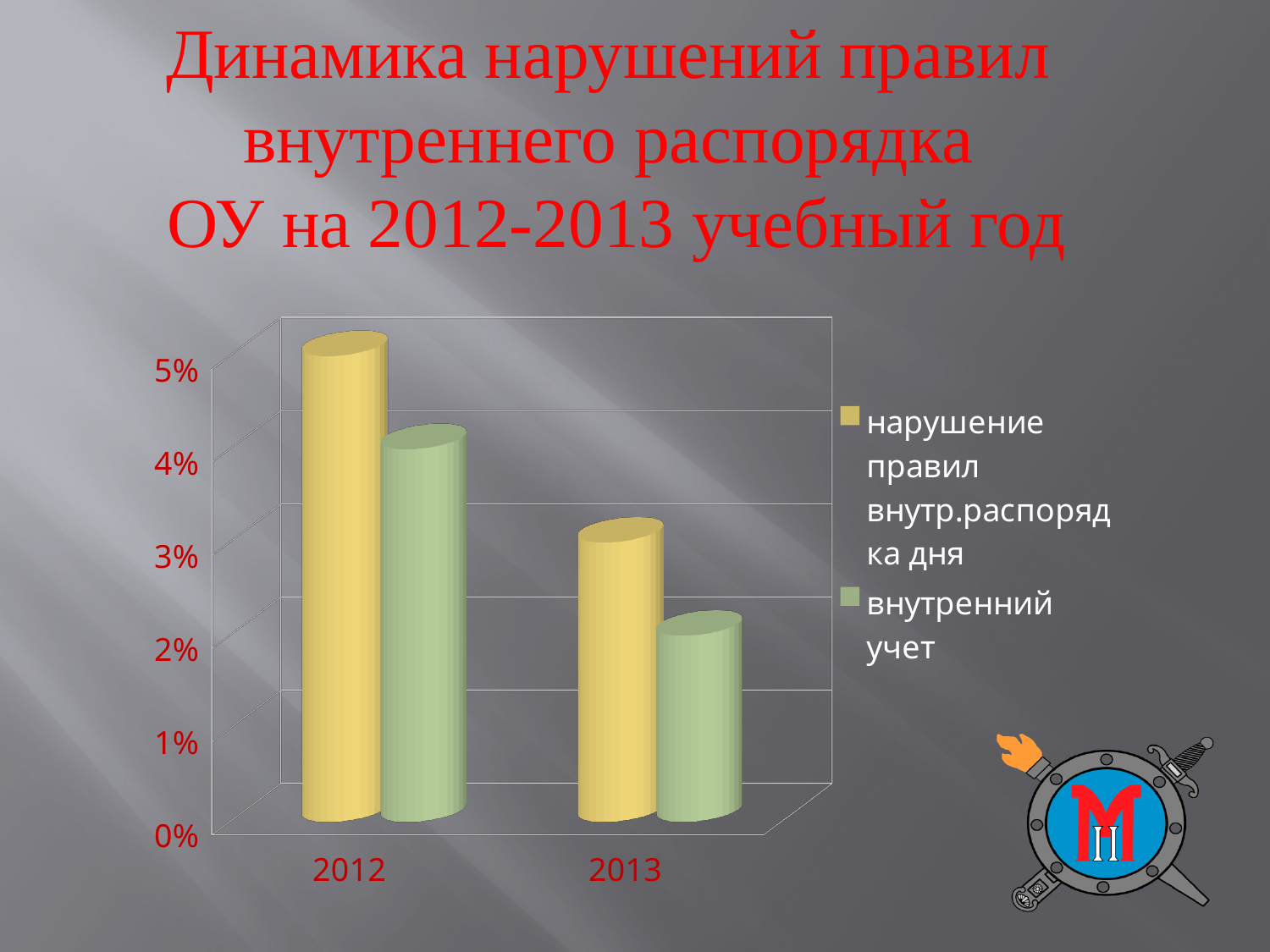
How many years are shown on the x axis of the chart? 2 Do the values for 'внутренний учет' rise or fall from 2012 to 2013? fall Is the value for 'внутренний учет' in 2013 greater or less than 3%? less Which year has the lowest bar for 'внутренний учет'? 2013 How many series does the chart legend list? 2 Is the value for 'нарушение правил внутр.распорядка дня' in 2013 greater or less than 4%? less In 2012, which series has the larger value: 'нарушение правил внутр.распорядка дня' or 'внутренний учет'? нарушение правил внутр.распорядка дня Is the value for 'нарушение правил внутр.распорядка дня' in 2012 greater or less than 4%? greater What is the highest percentage tick shown on the vertical axis? 5% Which year has the highest bar for 'нарушение правил внутр.распорядка дня'? 2012 What kind of chart is shown on the slide? bar chart Which colour represents 'внутренний учет' in the chart? green